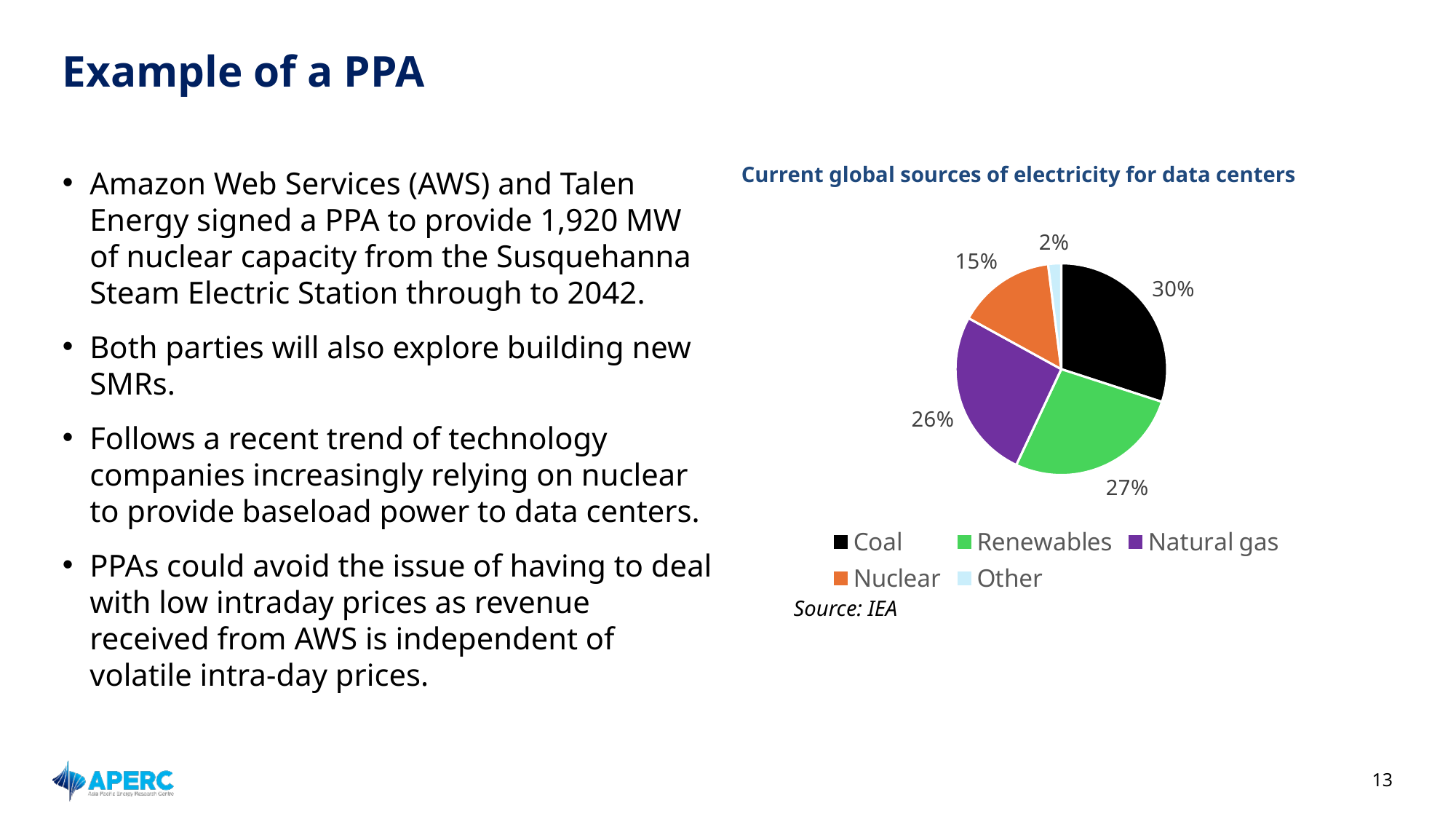
What share of electricity for data centers comes from Coal? 30% Which source has the smallest share of electricity for data centers? Other What is the difference in percentage points between the Coal share and the Nuclear share? 15 What share of electricity for data centers comes from Nuclear? 15% What share of electricity for data centers comes from Natural gas? 26% Which source has the largest share of electricity for data centers? Coal Which has a larger share, Renewables or Nuclear? Renewables What share of electricity for data centers comes from Renewables? 27% What share of electricity for data centers comes from Other? 2% What is the title of the chart? Current global sources of electricity for data centers How many categories does the pie chart show? 5 What type of chart is shown on the slide? Pie chart